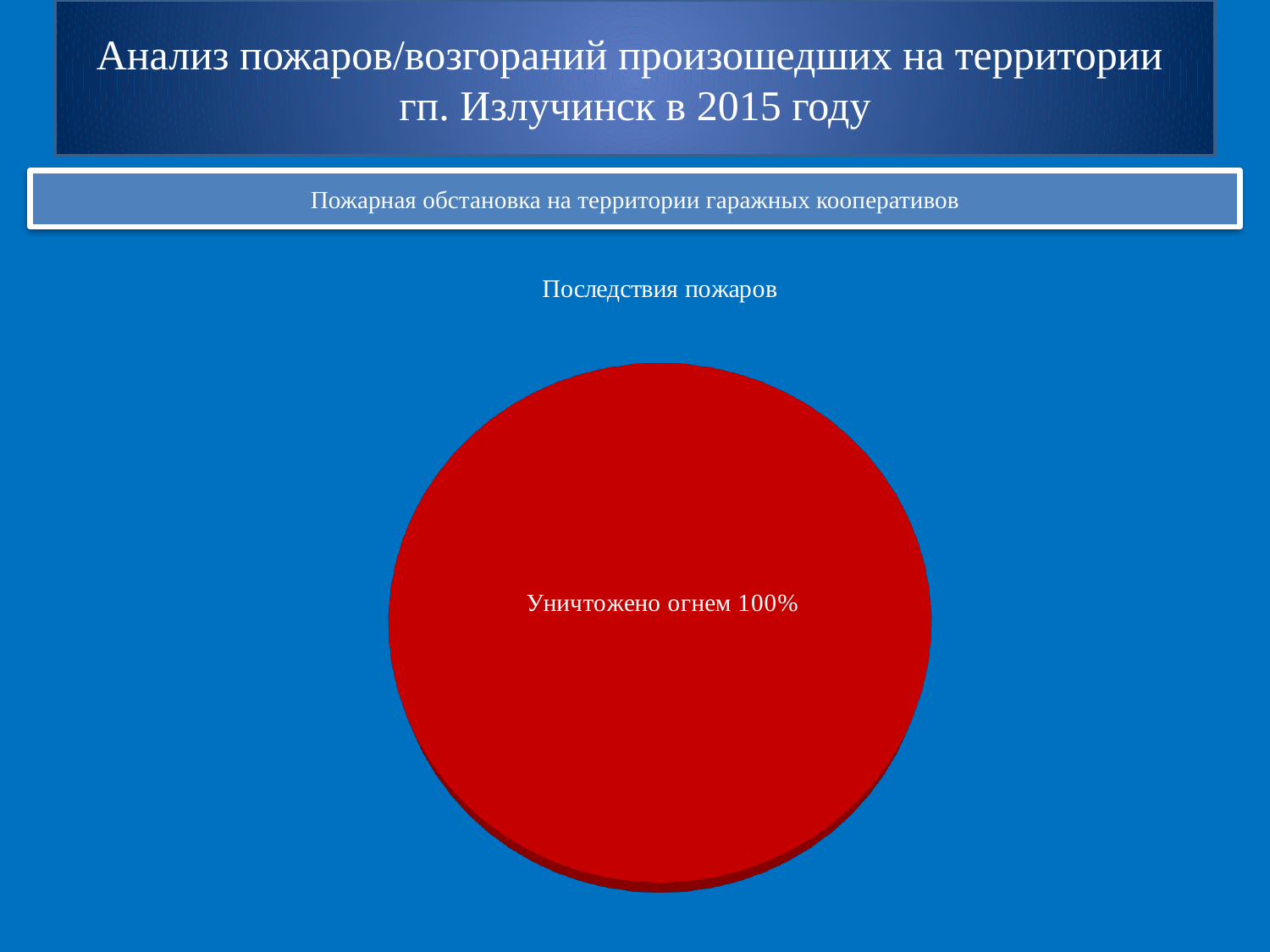
Is the share for "Уничтожено огнем" greater or less than 50%? greater What colour is the slice for "Уничтожено огнем"? red What kind of chart is shown on the slide? pie chart What is the label of the only slice in the pie chart? Уничтожено огнем What share of the pie does "Уничтожено огнем" represent? 100% What is the title of the chart? Последствия пожаров How many slices does the pie chart have? 1